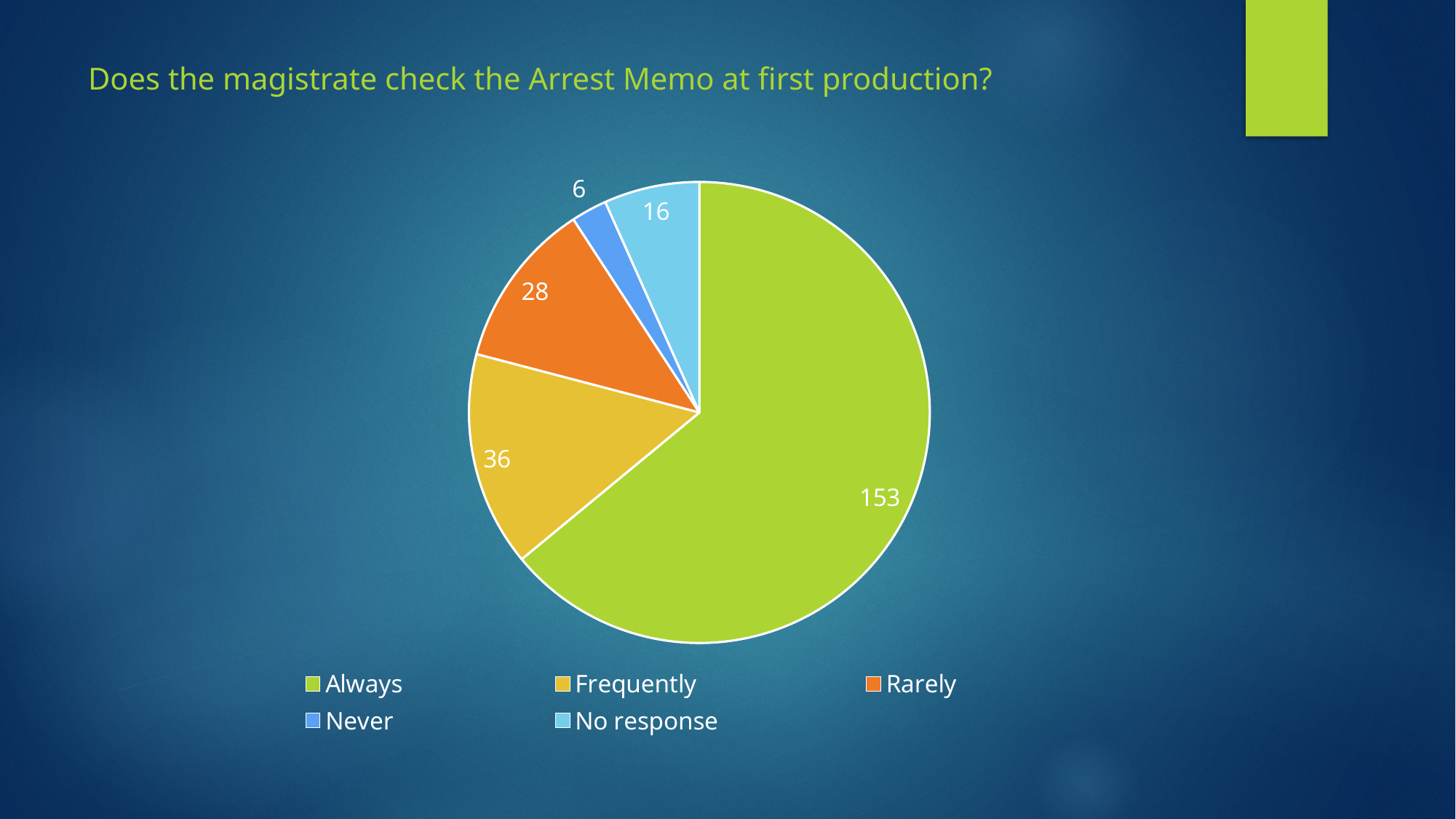
What kind of chart is shown on the slide? Pie chart What is the value for Frequently? 36 What is the value for Rarely? 28 Which is larger, the value for No response or the value for Never? No response What is the difference between the values for Frequently and Rarely? 8 What is the value for No response? 16 Which category has the largest slice? Always What is the title of the chart? Does the magistrate check the Arrest Memo at first production? What is the value for Never? 6 What is the value for Always? 153 How many categories does the pie chart show? 5 Which category has the smallest slice? Never